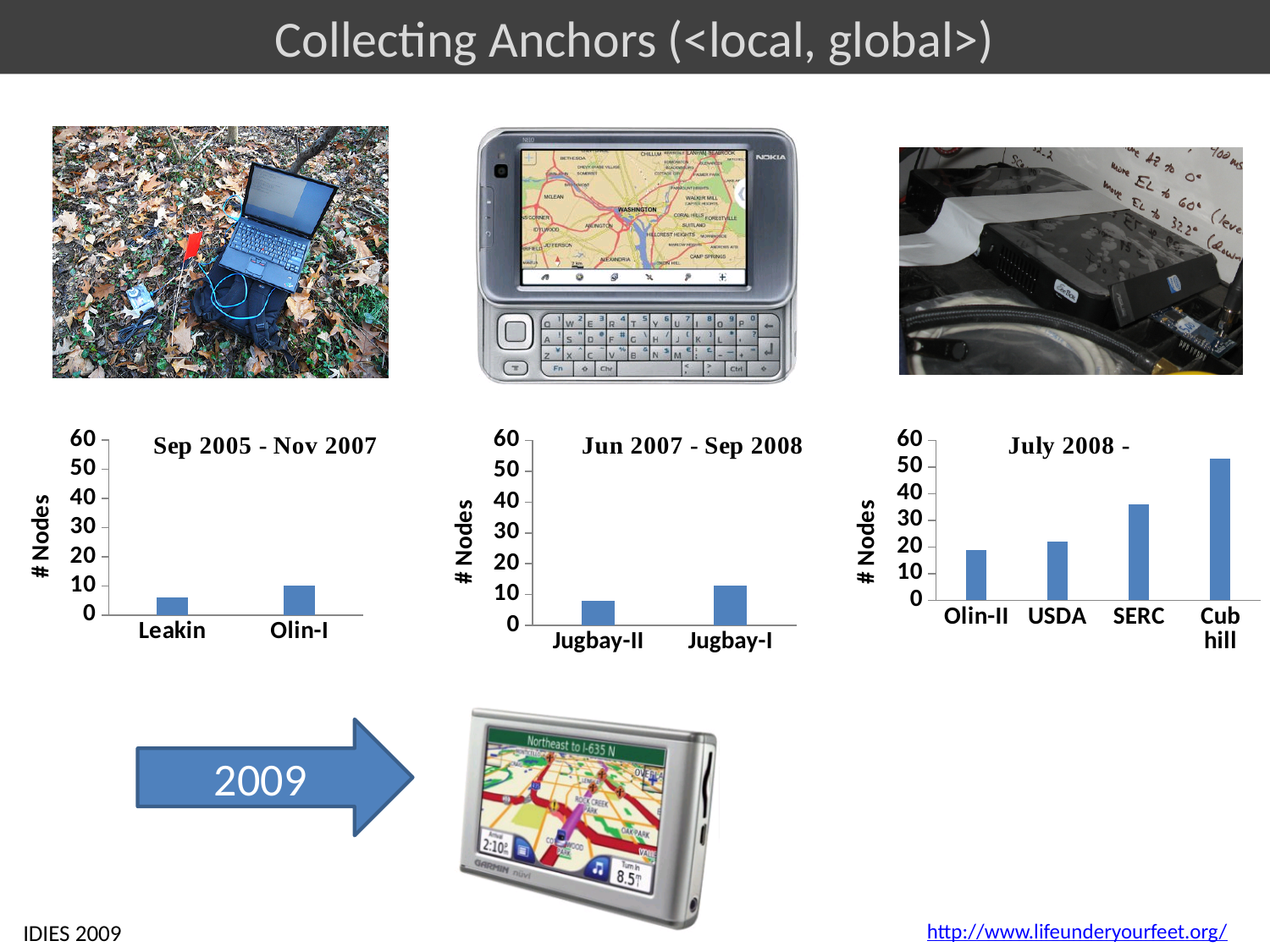
In the chart titled 'July 2008 -', do the values rise or fall from left to right along the x axis? rise In the chart titled 'July 2008 -', which category has the highest number of nodes? Cub hill In the chart titled 'Jun 2007 - Sep 2008', which category has the lower number of nodes? Jugbay-II In the chart titled 'July 2008 -', is the value for SERC greater or less than 30? greater In the chart titled 'Jun 2007 - Sep 2008', is the value for Jugbay-II greater or less than 10? less In the chart titled 'Sep 2005 - Nov 2007', which category has the higher number of nodes? Olin-I In the chart titled 'Sep 2005 - Nov 2007', is the value for Leakin greater or less than 10? less In the chart titled 'July 2008 -', which is larger, the value for USDA or the value for SERC? SERC How many categories are shown in the chart titled 'July 2008 -'? 4 In the chart titled 'July 2008 -', which category has the lowest number of nodes? Olin-II How many categories are shown in the chart titled 'Sep 2005 - Nov 2007'? 2